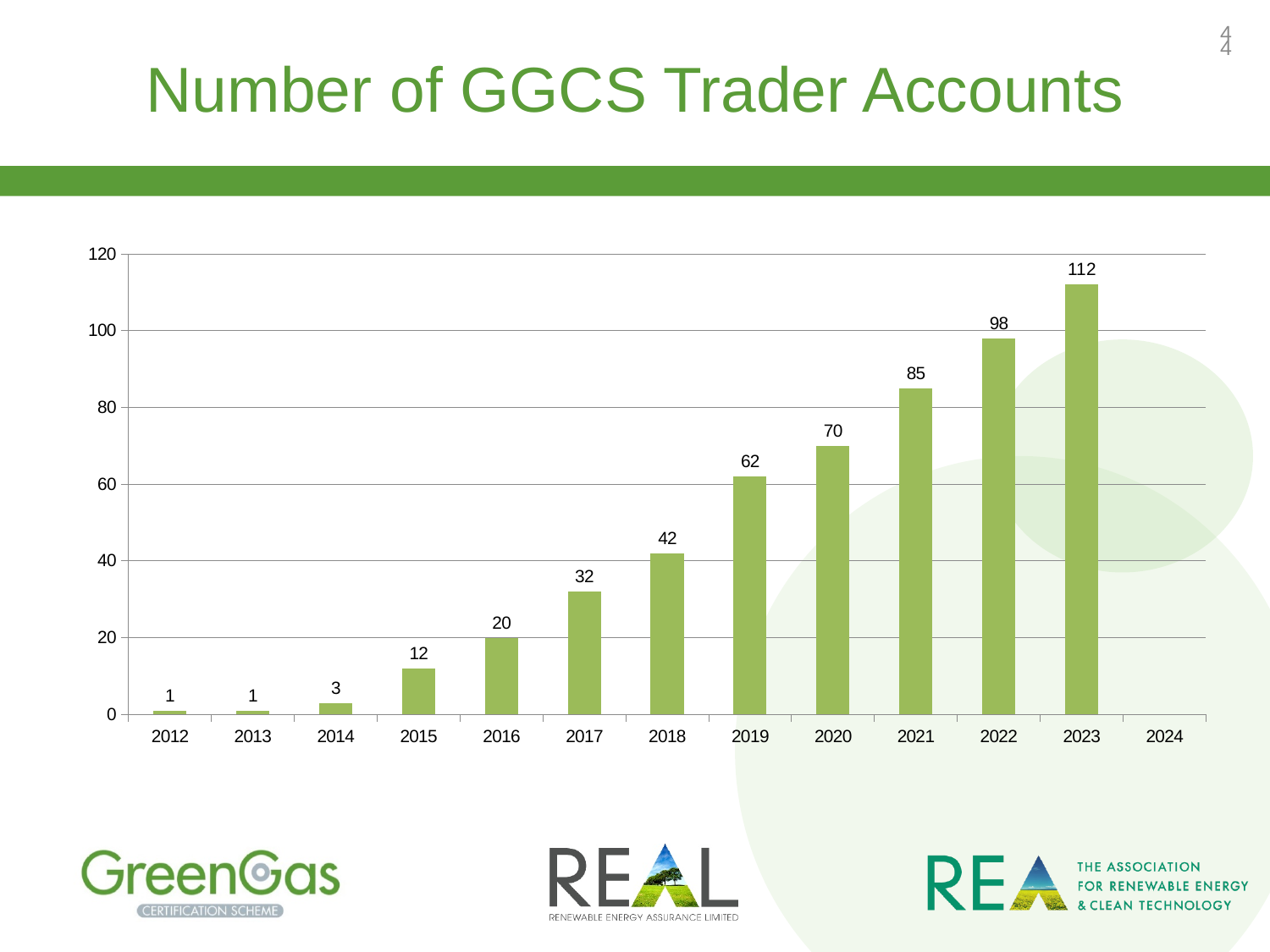
Do the values rise or fall from 2012 to 2023? Rise How many bars with data labels are shown on the chart? 12 What is the title of the chart? Number of GGCS Trader Accounts What kind of chart is shown on the slide? Bar chart What value is shown for 2016? 20 How much higher is the value for 2020 than for 2018? 28 What is the difference between the values for 2023 and 2022? 14 Which year has the highest number of trader accounts? 2023 What is the number of GGCS trader accounts in 2019? 62 What is the value for 2023? 112 Which is larger, the value for 2017 or the value for 2021? 2021 What is the lowest value shown on the chart? 1